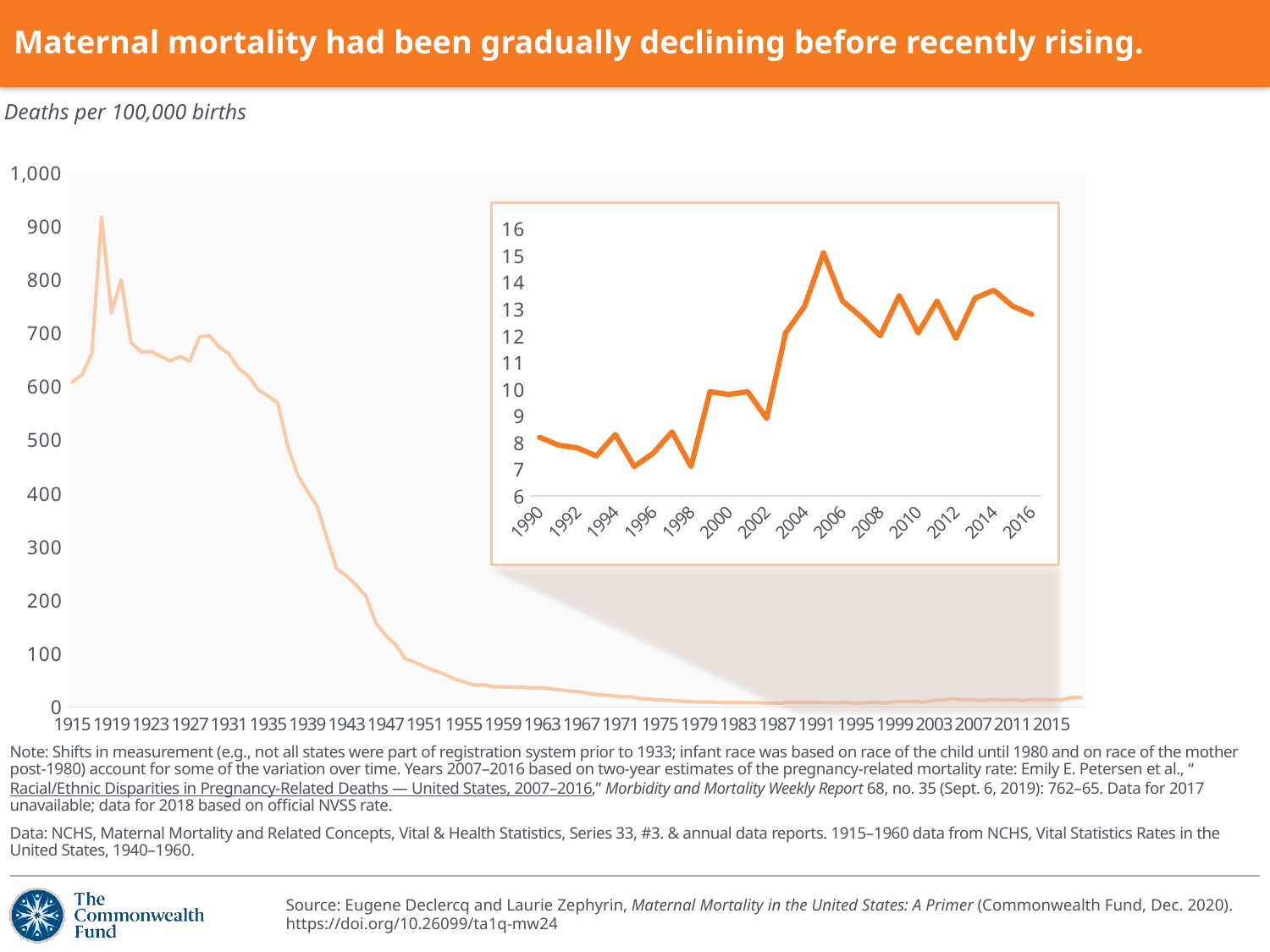
In the inset chart, is the value for 2016 greater or less than 12? greater What kind of chart is the inset chart showing 1990 to 2016? line chart What kind of chart is the large chart on the slide? line chart In the inset chart, which is larger, the value for 2005 or the value for 2010? 2005 In the inset chart, is the value for 1990 greater or less than 9? less In the large chart, is the value for 1915 greater or less than 500? greater What unit does the subtitle say the values are measured in? Deaths per 100,000 births In the inset chart, which year has the highest value? 2005 In the large chart, do the values overall rise or fall from 1915 to 2015? fall In the inset chart, do the values overall rise or fall from 1990 to 2016? rise